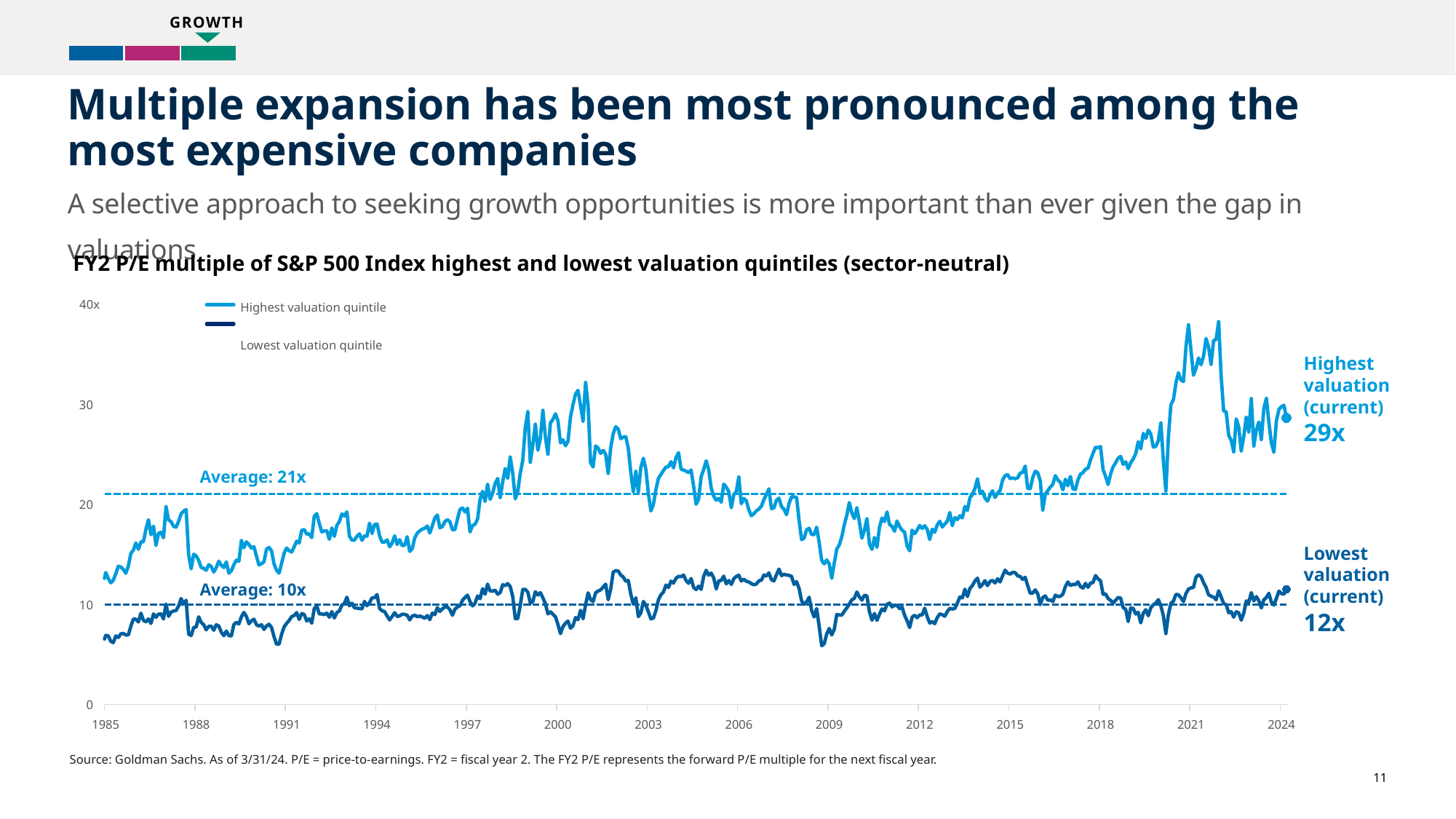
How many series does the legend list? 2 What kind of chart is shown on the slide? line chart Which is larger currently, the highest valuation quintile multiple or the lowest valuation quintile multiple? Highest valuation quintile Is the peak value of the highest valuation quintile around 2021 greater or less than 30? greater What is the average FY2 P/E multiple shown for the lowest valuation quintile? 10x What is the difference between the average multiple of the highest valuation quintile and the average multiple of the lowest valuation quintile? 11x What is the average FY2 P/E multiple shown for the highest valuation quintile? 21x What is the current FY2 P/E multiple of the lowest valuation quintile? 12x What is the current FY2 P/E multiple of the highest valuation quintile? 29x What is the title of the chart? FY2 P/E multiple of S&P 500 Index highest and lowest valuation quintiles (sector-neutral) What is the difference between the current highest valuation quintile multiple and the current lowest valuation quintile multiple? 17x Is the value of the lowest valuation quintile at the start of 1985 greater or less than 10? less